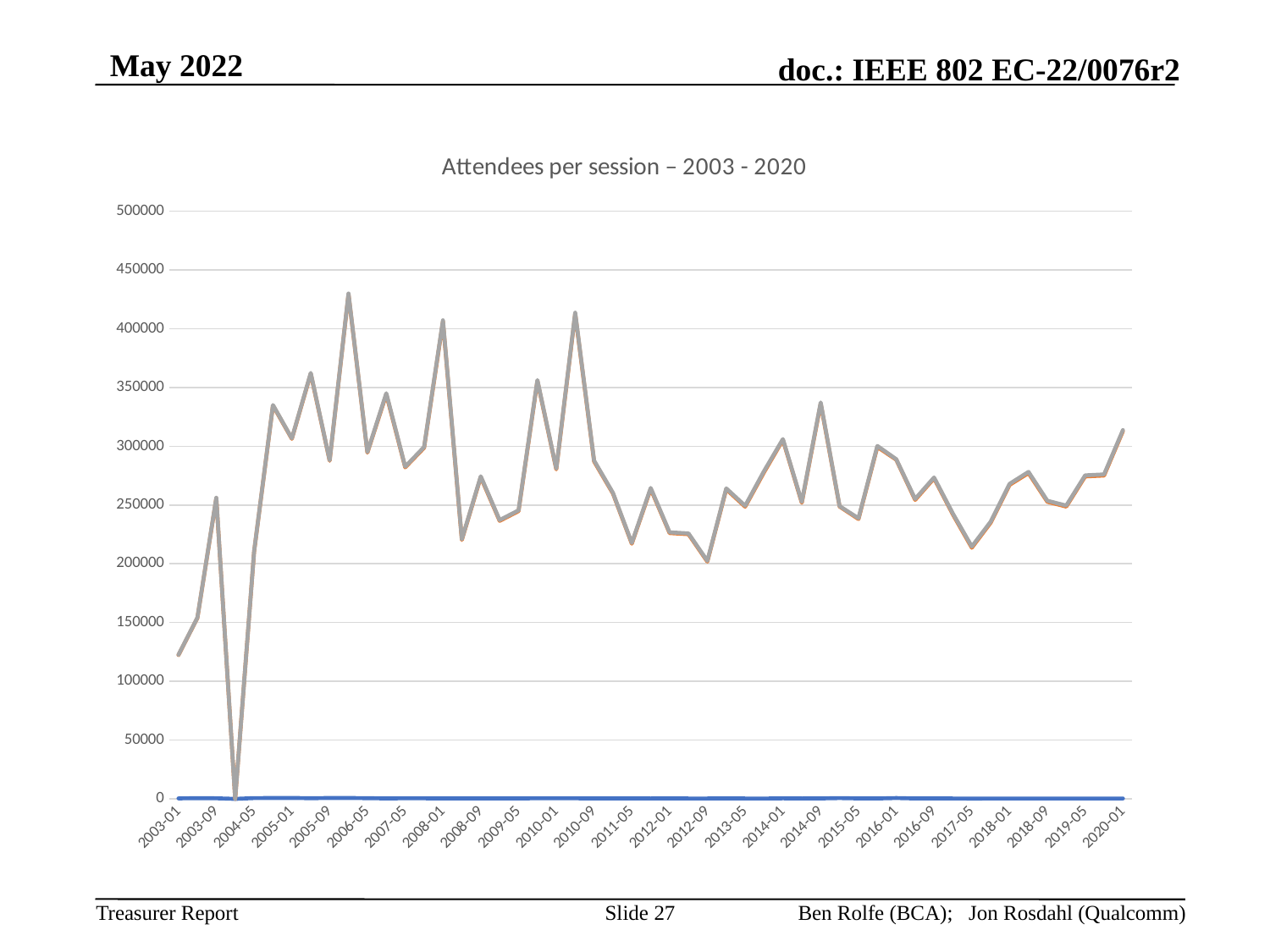
Is the value for 2020-01 greater or less than 300000? greater What kind of chart is shown on the slide? line chart Which is larger, the value for 2003-01 or the value for 2020-01? 2020-01 What is the highest value shown on the vertical axis? 500000 Which is larger, the value for 2014-09 or the value for 2017-05? 2014-09 What is the title of the chart? Attendees per session – 2003 - 2020 Is the value for 2008-09 greater or less than 250000? greater Is the value for 2017-05 greater or less than 250000? less Does the line rise or fall between 2016-01 and 2017-05? fall